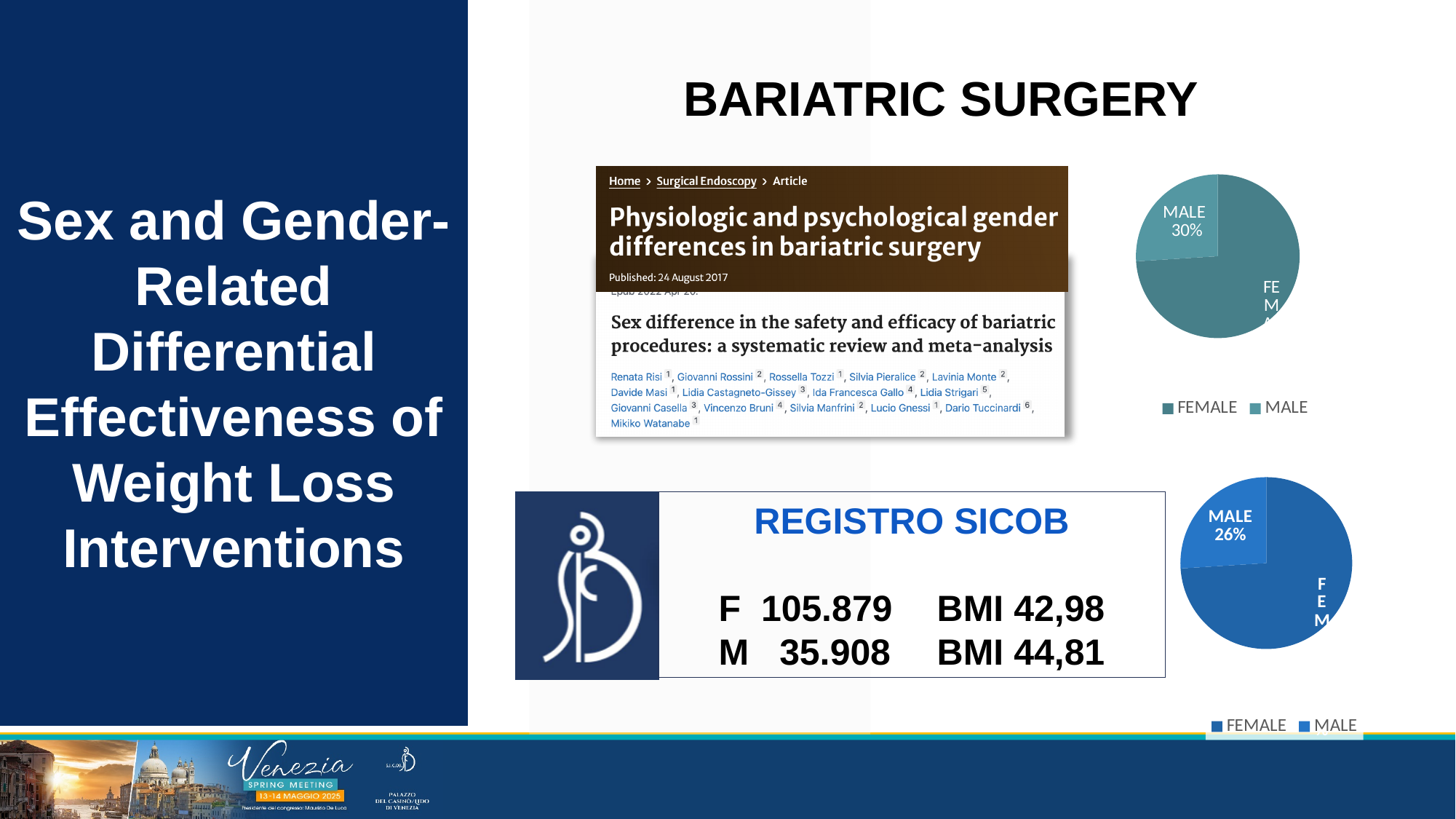
How many entries does the legend of the upper-right pie chart list? 2 Is the MALE share in the upper-right pie chart larger or smaller than the MALE share in the lower-right pie chart? Larger What kind of chart is the upper-right chart on the slide? Pie chart In the upper-right pie chart, what percentage is shown for MALE? 30% What kind of chart is the lower-right chart on the slide? Pie chart In the upper-right pie chart, which is larger, the FEMALE slice or the MALE slice? FEMALE In the upper-right pie chart, which slice is the largest? FEMALE Which two categories are listed in the legend of the lower-right pie chart? FEMALE and MALE In the lower-right pie chart, which is larger, the FEMALE slice or the MALE slice? FEMALE How many slices does the lower-right pie chart have? 2 In the lower-right pie chart, which slice is the smallest? MALE In the lower-right pie chart, what percentage is shown for MALE? 26%